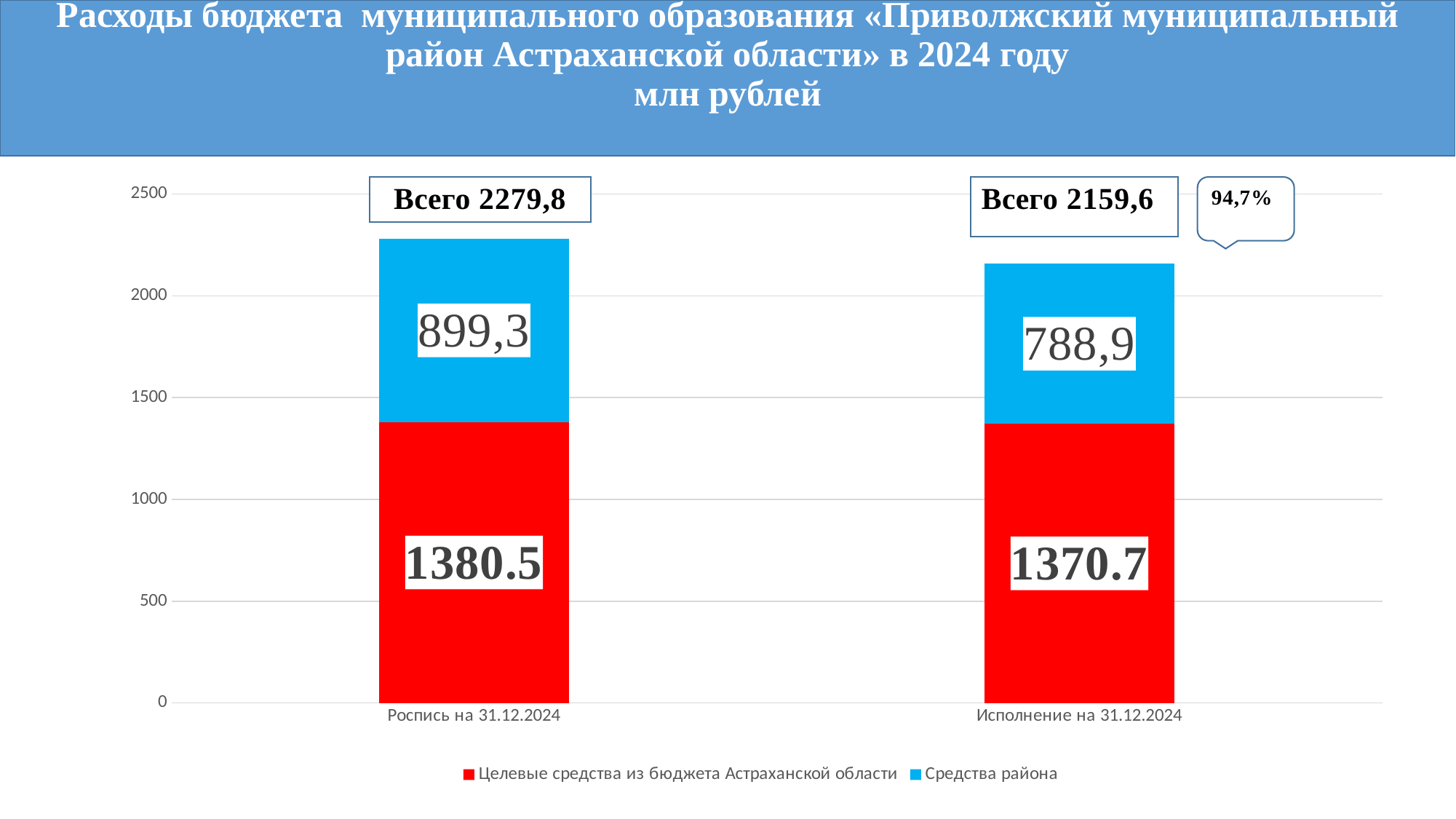
What is the total shown for the "Исполнение на 31.12.2024" bar? 2159,6 What type of chart is shown on the slide? Stacked bar chart How many bars (categories) are plotted on the chart? 2 What is the value of "Целевые средства из бюджета Астраханской области" for "Исполнение на 31.12.2024"? 1370.7 What percentage is shown in the callout next to the "Исполнение на 31.12.2024" bar? 94,7% What is the value of "Целевые средства из бюджета Астраханской области" for "Роспись на 31.12.2024"? 1380.5 How many series does the legend list? 2 Which category has the larger value for "Средства района": "Роспись на 31.12.2024" or "Исполнение на 31.12.2024"? Роспись на 31.12.2024 What is the total shown for the "Роспись на 31.12.2024" bar? 2279,8 What is the value of "Средства района" for "Исполнение на 31.12.2024"? 788,9 What is the difference between the "Средства района" values for "Роспись на 31.12.2024" and "Исполнение на 31.12.2024"? 110,4 What is the value of "Средства района" for "Роспись на 31.12.2024"? 899,3